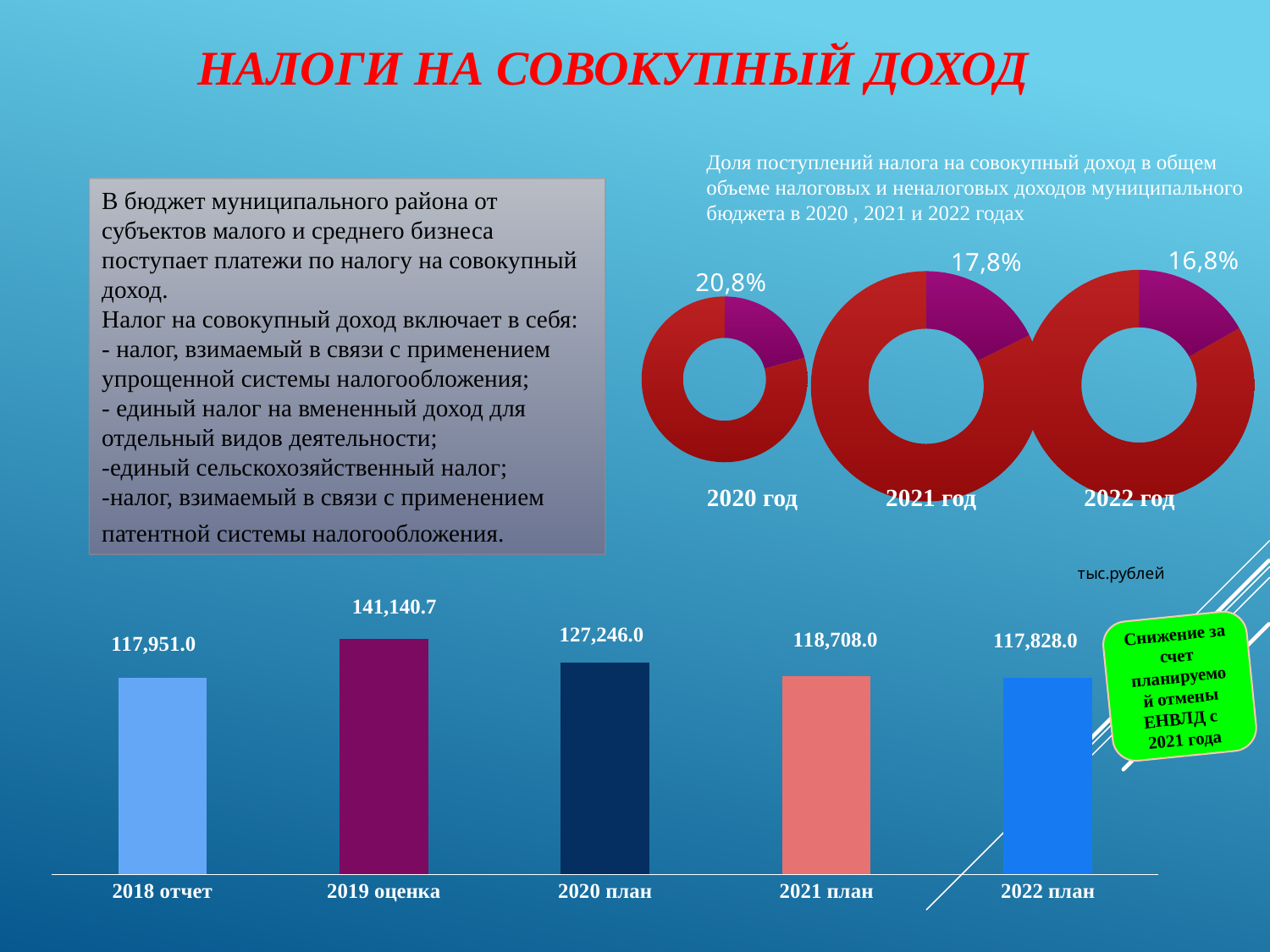
In the bottom bar chart, what is the value for 2021 план? 118,708.0 In the bottom bar chart, which category has the highest value? 2019 оценка In the donut charts at the top right, what share is shown for 2021 год? 17,8% In the bottom bar chart, what is the difference between the values for 2019 оценка and 2018 отчет? 23,189.7 How many categories are shown in the bottom bar chart? 5 In the bottom bar chart, which category has the lowest value? 2022 план What kind of chart is shown at the bottom of the slide? bar chart In the bottom bar chart, what is the value for 2019 оценка? 141,140.7 In the bottom bar chart, do the values rise or fall from 2019 оценка to 2022 план? fall In the bottom bar chart, what is the difference between the values for 2020 план and 2021 план? 8,538.0 In the bottom bar chart, which is larger: the value for 2021 план or 2022 план? 2021 план In the donut charts at the top right, which year has the highest share? 2020 год